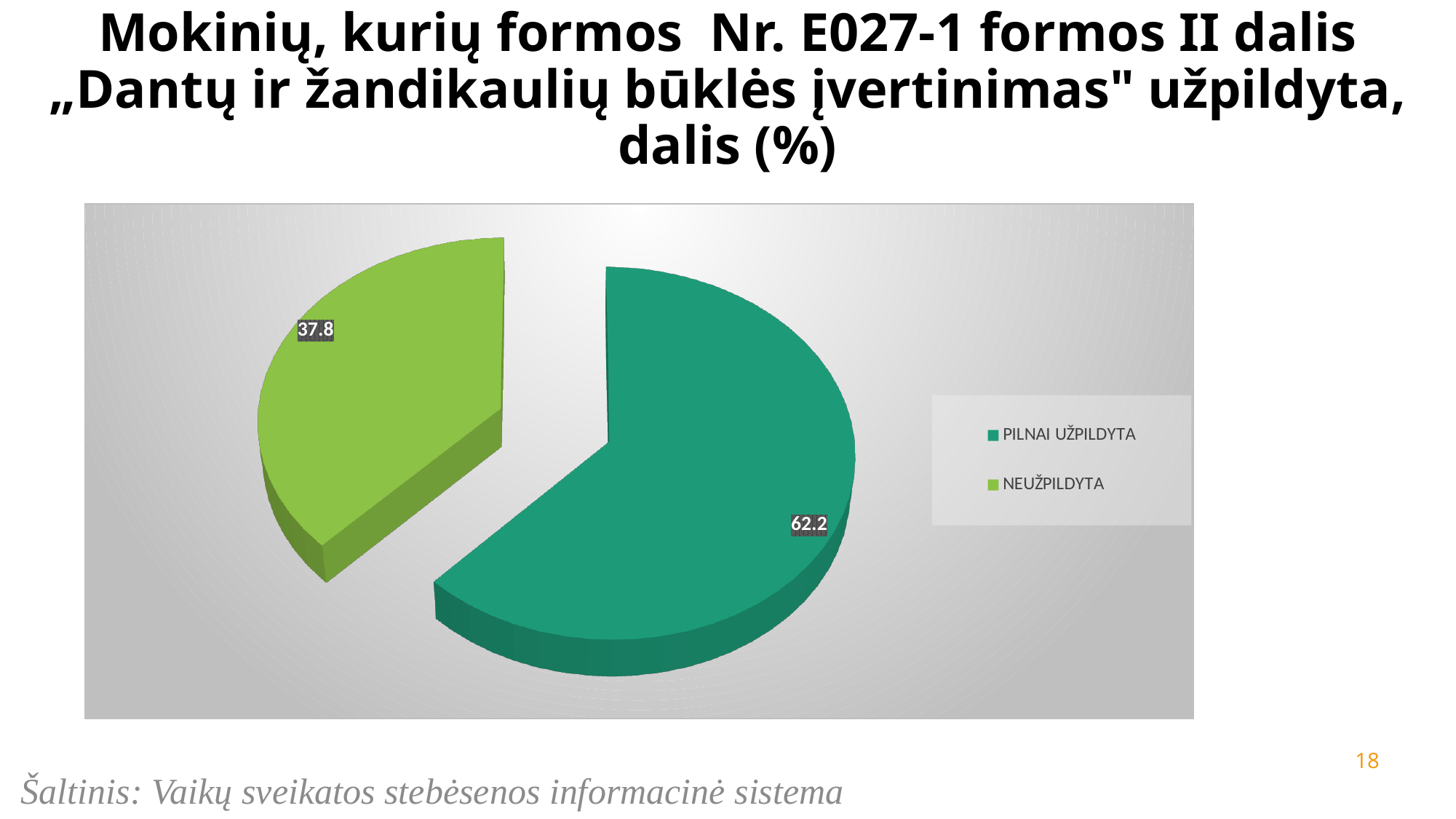
What colour is the slice for NEUŽPILDYTA? green How many slices does the pie chart have? 2 What kind of chart is shown on the slide? pie chart Which category has the smallest share of the pie? NEUŽPILDYTA What source is cited below the chart? Vaikų sveikatos stebėsenos informacinė sistema Which category has the largest share of the pie? PILNAI UŽPILDYTA What is the value for PILNAI UŽPILDYTA? 62.2 Which is larger, the value for PILNAI UŽPILDYTA or NEUŽPILDYTA? PILNAI UŽPILDYTA What is the total of the two slice values shown on the pie chart? 100 What is the difference between the values for PILNAI UŽPILDYTA and NEUŽPILDYTA? 24.4 How many entries does the legend list? 2 What is the value for NEUŽPILDYTA? 37.8